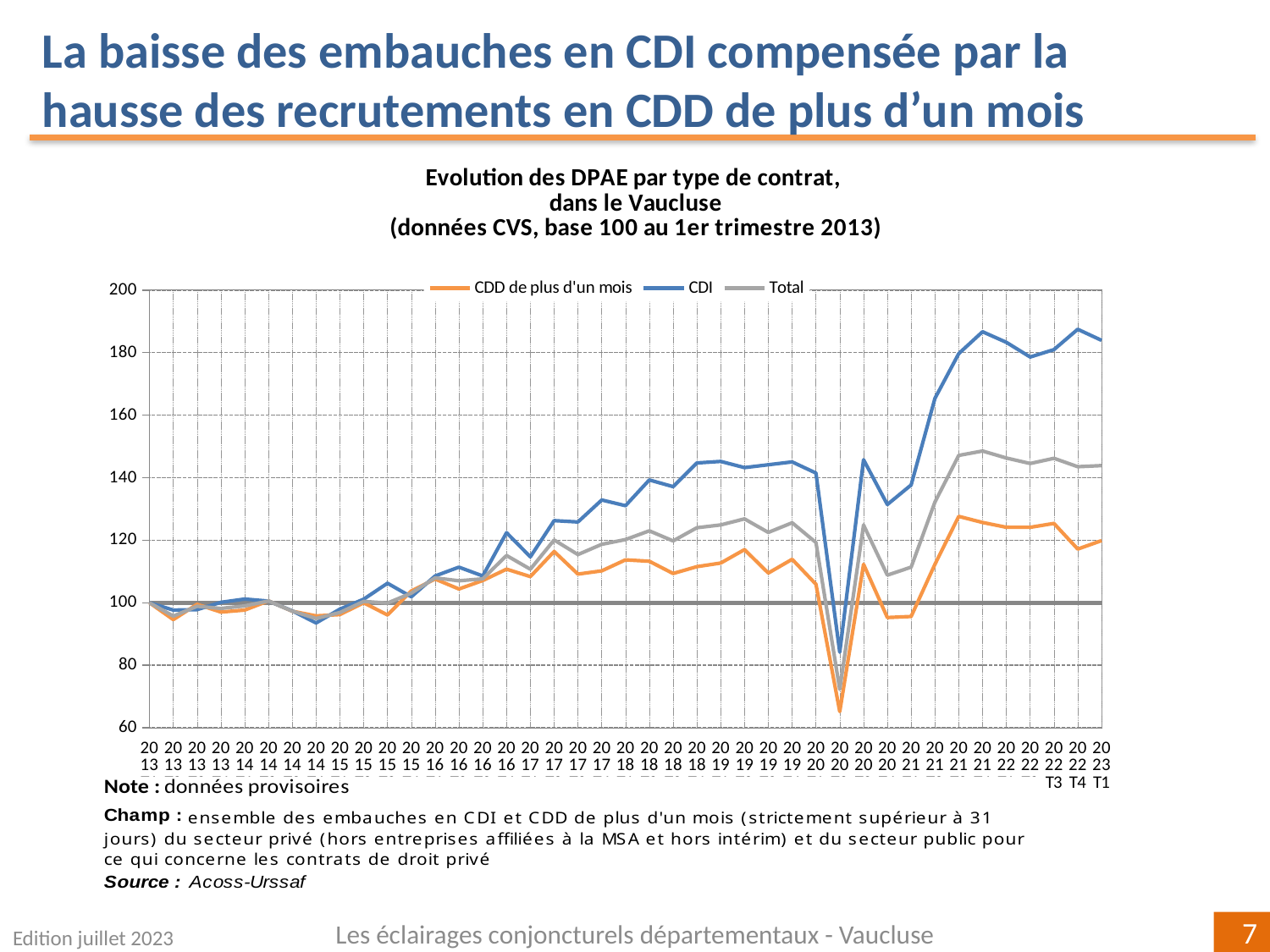
What are the three series named in the legend? CDD de plus d'un mois, CDI, Total What kind of chart is shown on the slide? line chart How many series does the legend list? 3 Is the value of CDD de plus d'un mois at 2020 T2 greater or less than 80? less Is the value of CDI at 2020 T2 greater or less than 100? less Which series reaches the highest value on the chart? CDI Is the value of CDI at 2023 T1 greater or less than 160? greater Between 2013 and 2019, does the CDI series generally rise or fall? rise At 2023 T1, which is higher: CDI or CDD de plus d'un mois? CDI Which series is drawn in orange? CDD de plus d'un mois Which series falls to the lowest value on the chart? CDD de plus d'un mois